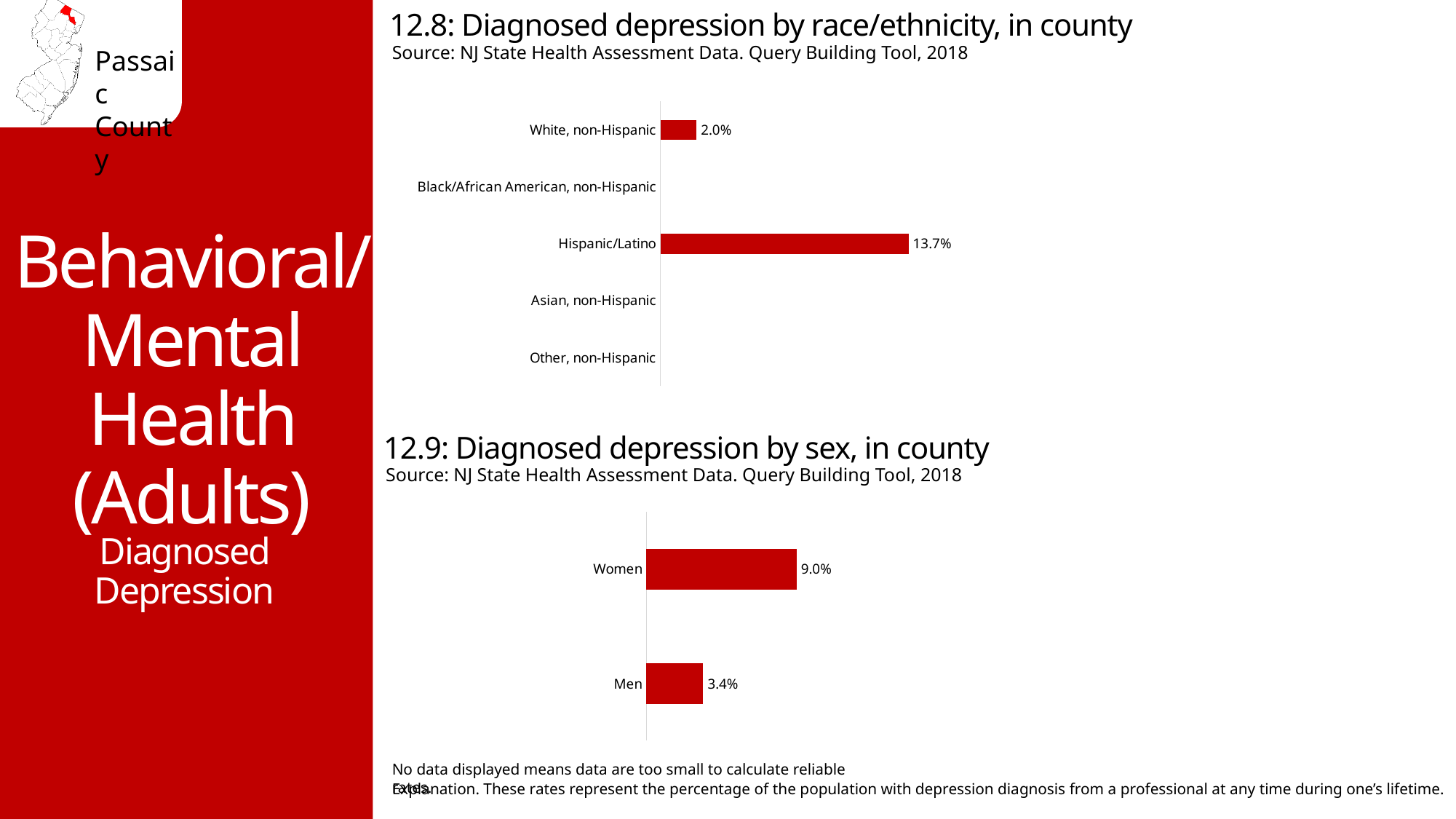
In the chart '12.8: Diagnosed depression by race/ethnicity, in county', what is the difference between the Hispanic/Latino and White, non-Hispanic values? 11.7% In the chart '12.8: Diagnosed depression by race/ethnicity, in county', how many categories are listed on the axis? 5 In the chart '12.8: Diagnosed depression by race/ethnicity, in county', how many categories have a bar displayed? 2 What kind of chart is '12.8: Diagnosed depression by race/ethnicity, in county'? Bar chart In the chart '12.8: Diagnosed depression by race/ethnicity, in county', what is the value for White, non-Hispanic? 2.0% In the chart '12.8: Diagnosed depression by race/ethnicity, in county', which category has the highest value? Hispanic/Latino In the chart '12.9: Diagnosed depression by sex, in county', what is the value for Men? 3.4% What is the source cited for the chart '12.9: Diagnosed depression by sex, in county'? NJ State Health Assessment Data. Query Building Tool, 2018 In the chart '12.9: Diagnosed depression by sex, in county', what is the value for Women? 9.0% In the chart '12.9: Diagnosed depression by sex, in county', which category has the higher value, Women or Men? Women In the chart '12.9: Diagnosed depression by sex, in county', what is the difference between the Women and Men values? 5.6% In the chart '12.8: Diagnosed depression by race/ethnicity, in county', what is the value for Hispanic/Latino? 13.7%